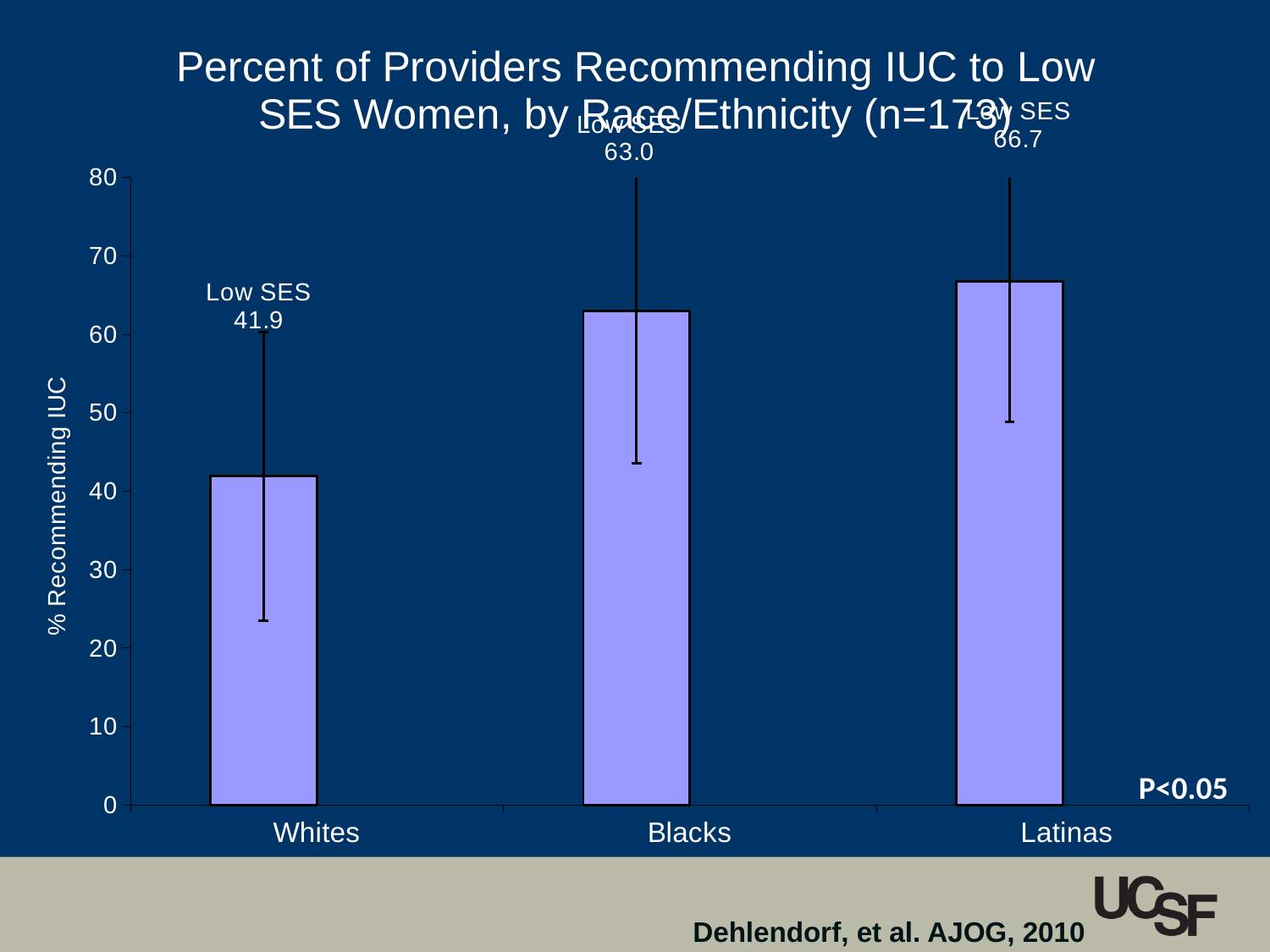
Which category has the lowest percent of providers recommending IUC? Whites Is the value for Whites greater or less than 50? less What is the label of the y axis? % Recommending IUC What is the value for Blacks? 63.0 What is the difference between the values for Latinas and Blacks? 3.7 How many categories are shown on the x axis? 3 What is the value for Whites? 41.9 What is the difference between the values for Blacks and Whites? 21.1 What kind of chart is shown on the slide? bar chart Which category has the highest percent of providers recommending IUC? Latinas Which is larger, the value for Whites or the value for Blacks? Blacks What is the value for Latinas? 66.7